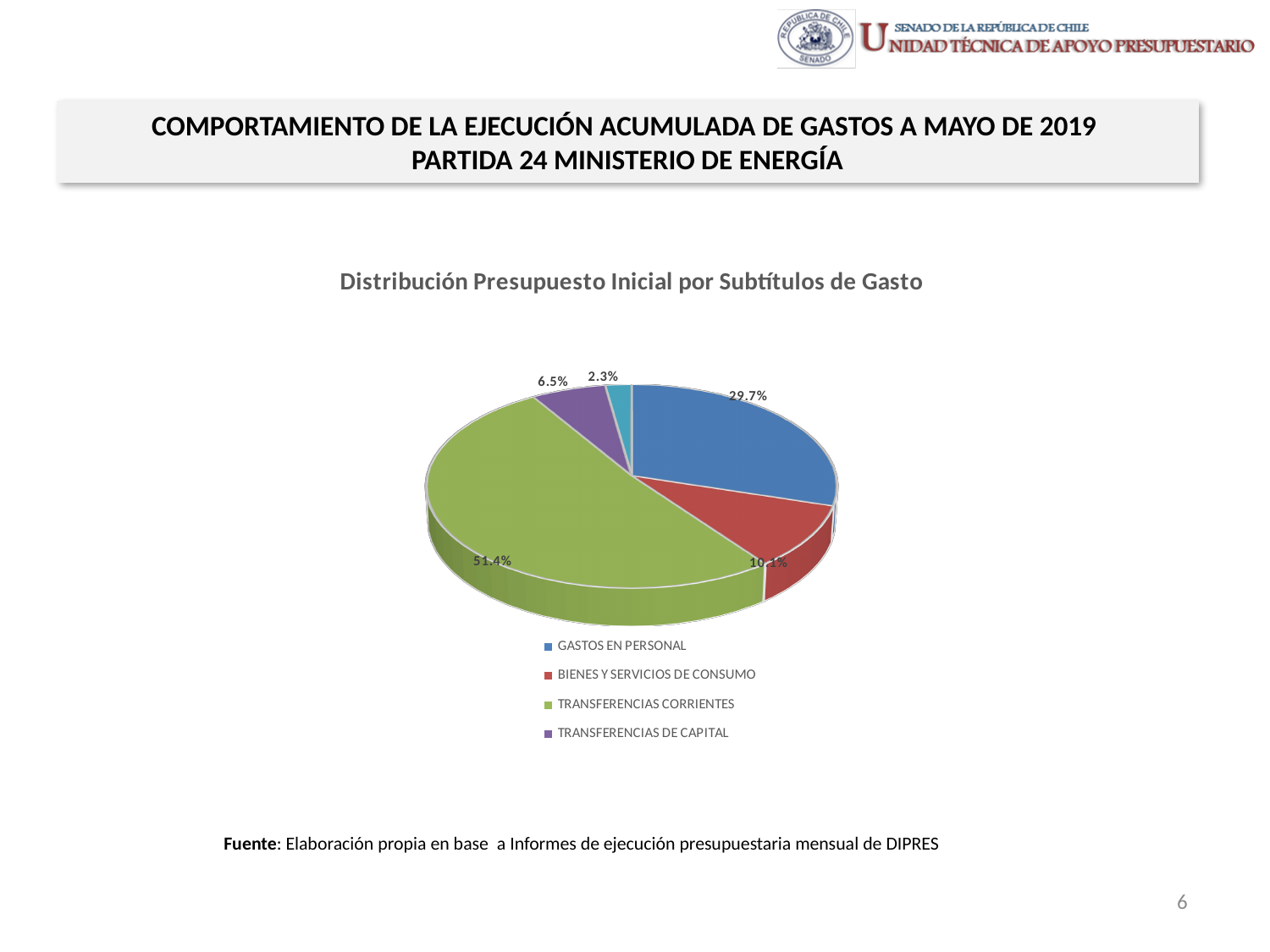
What colour is the slice for TRANSFERENCIAS CORRIENTES? green Which category has the largest slice of the pie? TRANSFERENCIAS CORRIENTES How many entries does the legend list? 4 What share of the pie does BIENES Y SERVICIOS DE CONSUMO represent? 10.1% What kind of chart is shown on the slide? pie chart What is the difference in percentage points between TRANSFERENCIAS CORRIENTES and GASTOS EN PERSONAL? 21.7 percentage points Which is larger, the slice for GASTOS EN PERSONAL or the slice for BIENES Y SERVICIOS DE CONSUMO? GASTOS EN PERSONAL What is the title of the chart? Distribución Presupuesto Inicial por Subtítulos de Gasto What is the difference in percentage points between BIENES Y SERVICIOS DE CONSUMO and TRANSFERENCIAS DE CAPITAL? 3.6 percentage points What share of the pie does TRANSFERENCIAS CORRIENTES represent? 51.4% What share of the pie does GASTOS EN PERSONAL represent? 29.7%